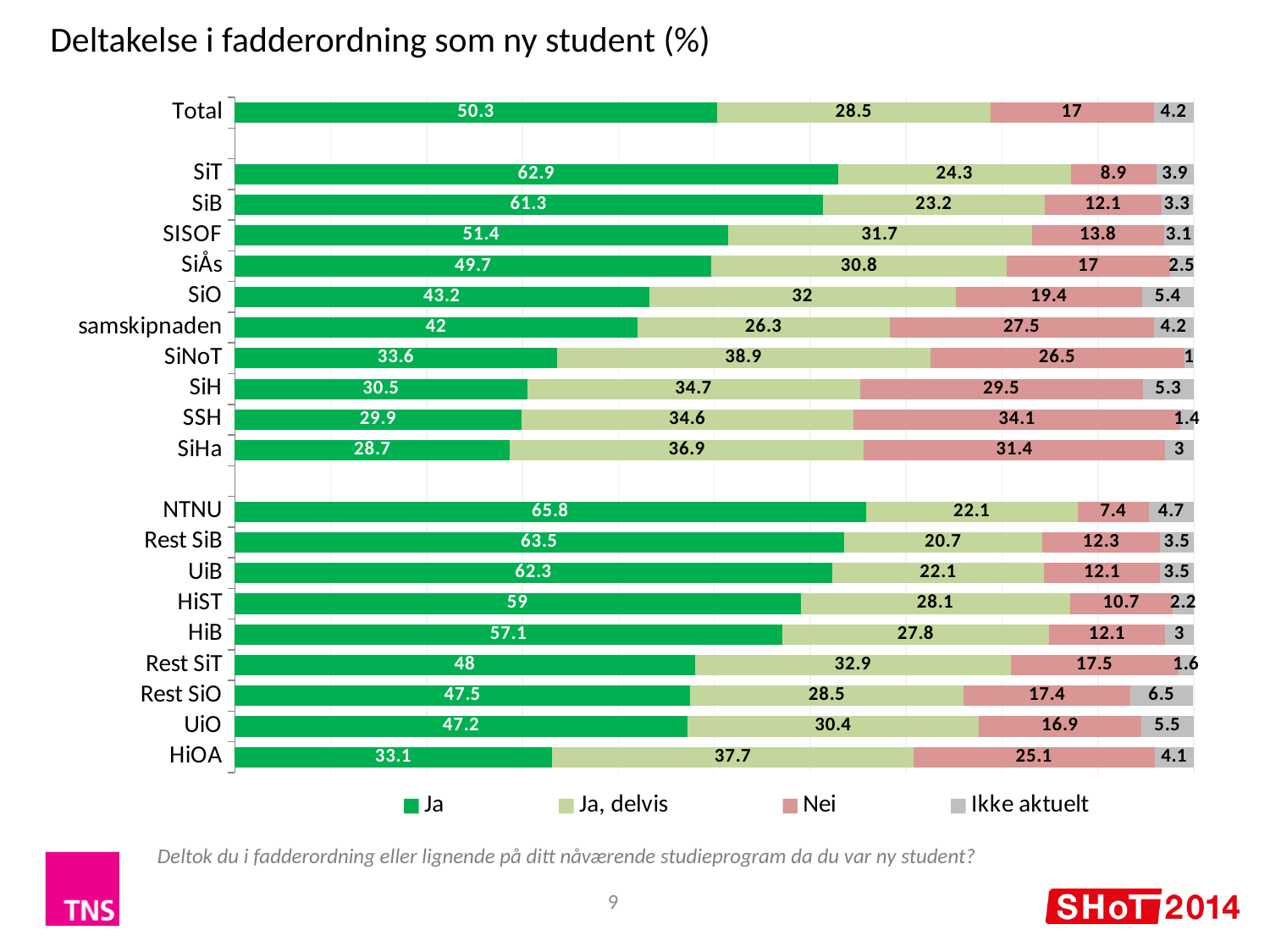
Which category has the highest "Ja" value? NTNU Which has the larger "Ja, delvis" value, SiNoT or SiHa? SiNoT What kind of chart is shown on the slide? Stacked bar chart What is the difference between the "Ja" values for SiT and SiB? 1.6 What is the total of the stacked bar for SiT? 100 What is the "Ikke aktuelt" value for Rest SiO? 6.5 How many categories (rows) are shown in the chart? 20 Which category has the lowest "Ja" value? SiHa How many series does the legend list? 4 What is the "Nei" value for samskipnaden? 27.5 What is the value of the "Ja" series for NTNU? 65.8 What is the "Ja, delvis" value for HiOA? 37.7